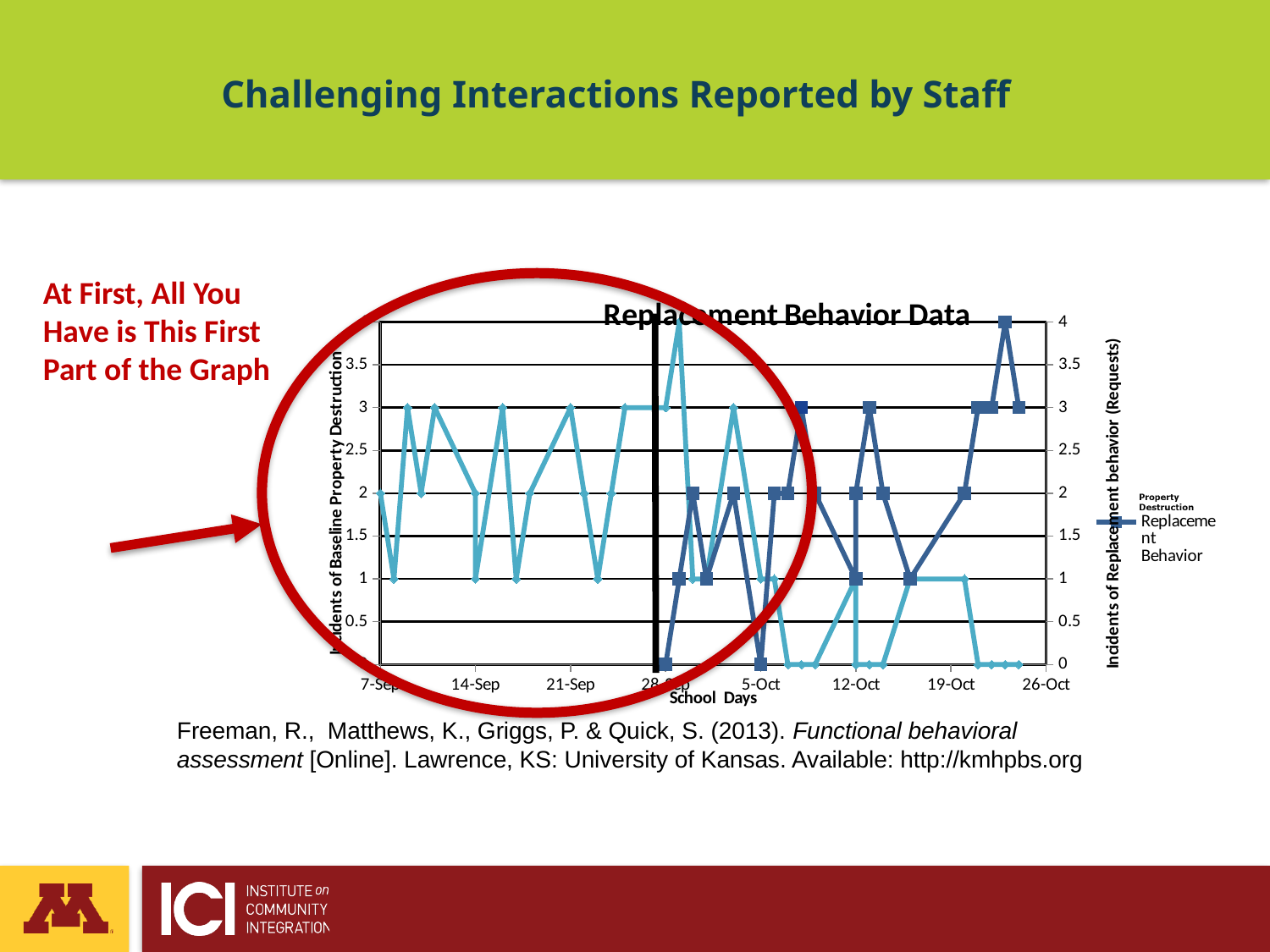
What is the lowest value reached by the Property Destruction series? 0 What are the two series named in the legend of the chart? Property Destruction and Replacement Behavior Does the Property Destruction series generally rise or fall from 7-Sep to 26-Oct? Fall What is the title of the chart on the slide? Replacement Behavior Data Does the Replacement Behavior series generally rise or fall across the school days shown? Rise What kind of chart is shown on the slide? Line chart Is the Property Destruction value on 7-Sep greater or less than 1? greater How many series does the legend of the Replacement Behavior Data chart list? 2 What is the highest value reached by the Replacement Behavior series? 4 Which series has the higher value at the end of the period shown, Property Destruction or Replacement Behavior? Replacement Behavior Is the Replacement Behavior value on 28-Sep greater or less than 1? less What is the highest value reached by the Property Destruction series? 4